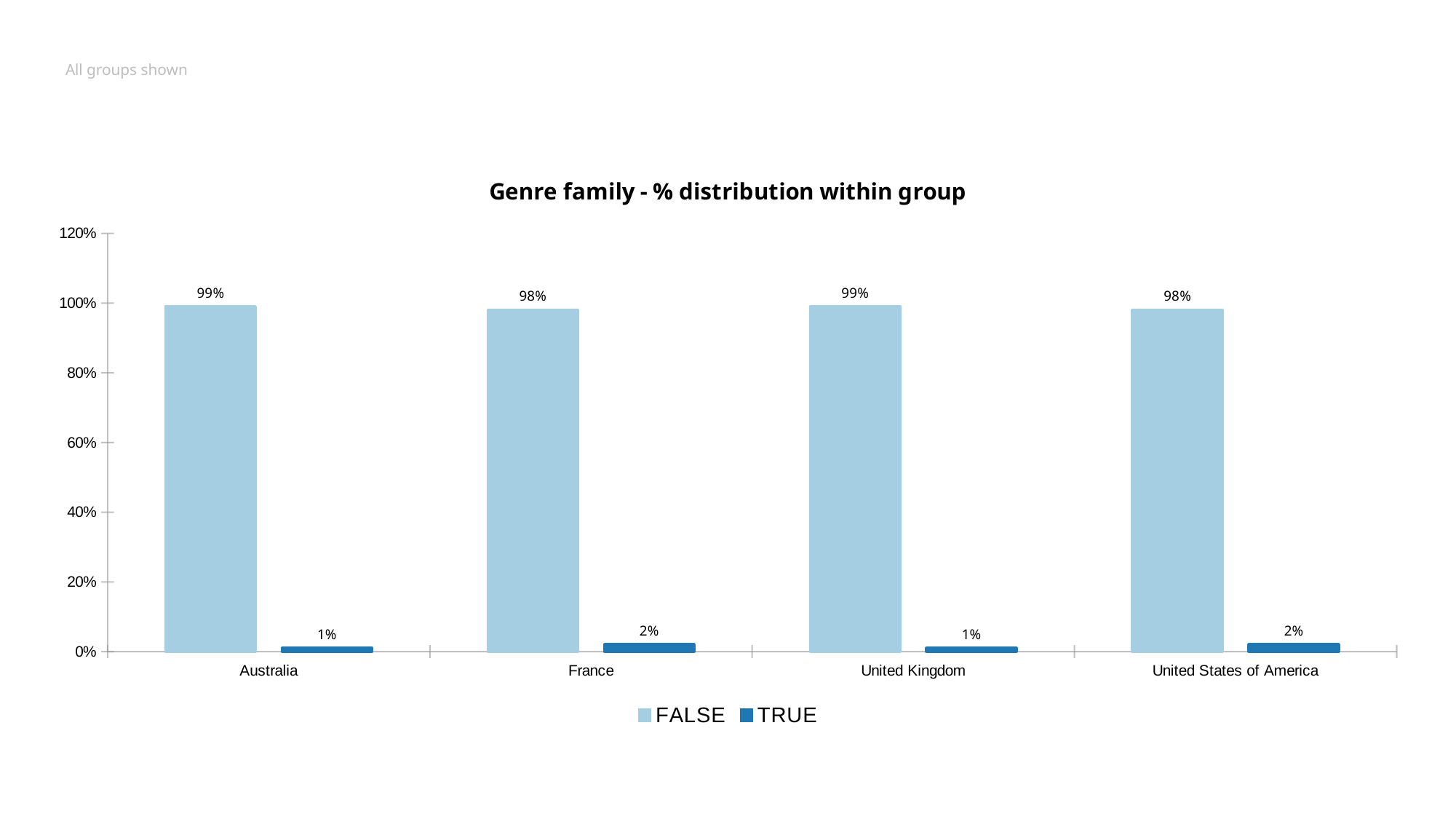
Which is larger for Australia, the FALSE value or the TRUE value? FALSE What is the title of the chart? Genre family - % distribution within group What is the TRUE value for United Kingdom? 1% Which series is shown in the darker blue colour? TRUE What is the FALSE value for United States of America? 98% Is the FALSE value for United Kingdom greater or less than 80%? greater What is the TRUE value for France? 2% What is the FALSE value for Australia? 99% How many categories are shown on the x axis? 4 What is the difference between the FALSE and TRUE values for France? 96% How many series does the legend list? 2 What kind of chart is shown on the slide? Bar chart